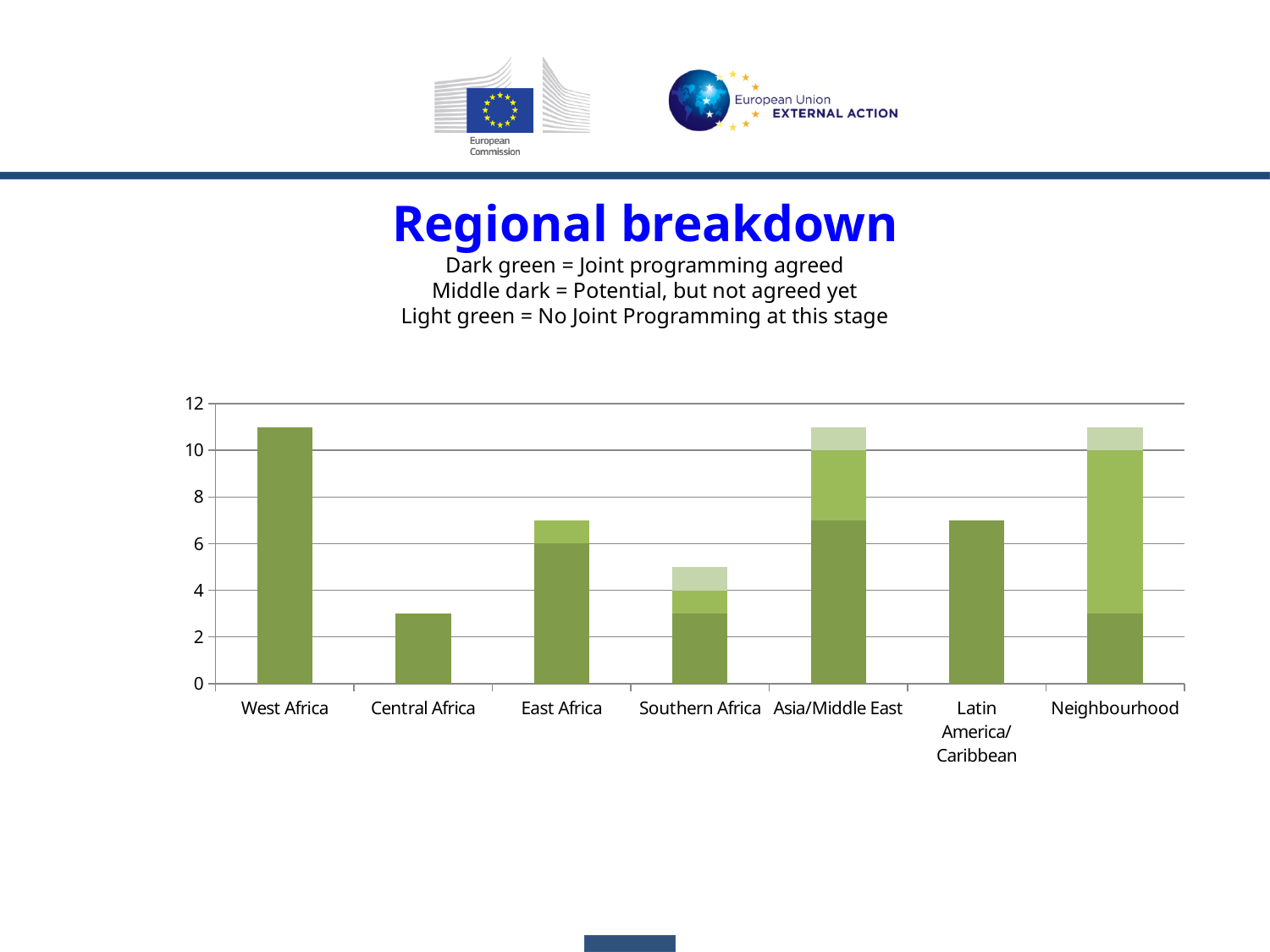
Which region has the lowest total bar in the chart? Central Africa How many regions are shown on the x axis of the chart? 7 Is the total value for Central Africa greater or less than 4? less What type of chart is shown on the slide? Stacked bar chart Which region has the tallest dark green (Joint programming agreed) segment? West Africa What is the title of the chart on the slide? Regional breakdown Is the total value for Southern Africa greater or less than 6? less Is the total value for Latin America/Caribbean greater or less than 8? less According to the slide text, what does the dark green colour represent? Joint programming agreed Which has the larger total bar, Latin America/Caribbean or Central Africa? Latin America/Caribbean Which has the larger total bar, East Africa or Southern Africa? East Africa